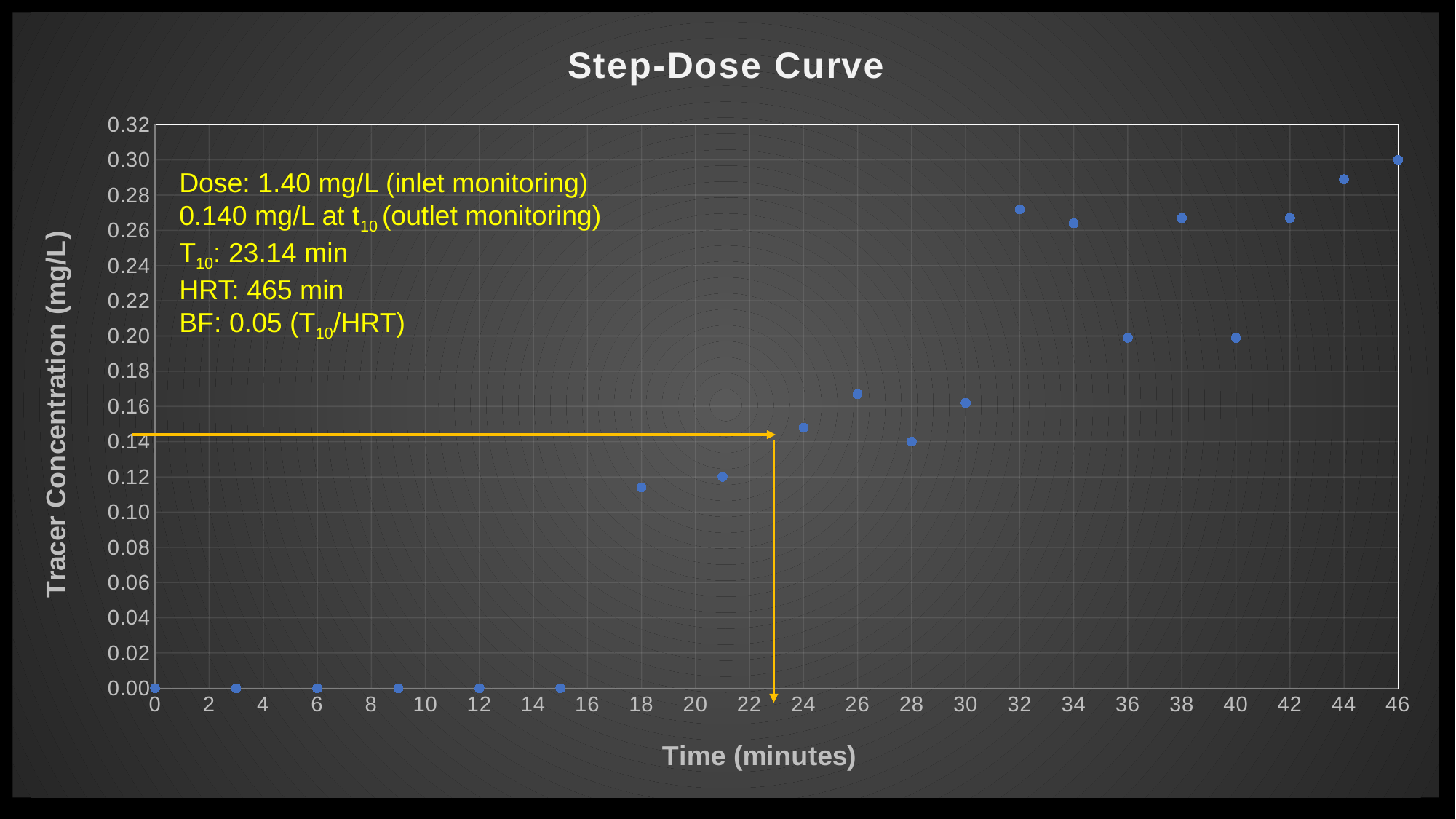
What kind of chart is shown on the slide? Scatter chart Which has the higher tracer concentration, 26 minutes or 28 minutes? 26 minutes What is the title of the chart? Step-Dose Curve Is the tracer concentration at 18 minutes greater or less than 0.10? greater How many data points are plotted on the chart? 20 What is the tracer concentration at 0 minutes? 0.00 What is the label of the x axis? Time (minutes) Is the tracer concentration at 32 minutes greater or less than 0.26? greater What is the tracer concentration at 12 minutes? 0.00 At which time is the tracer concentration highest? 46 minutes Overall, does the tracer concentration rise or fall as time increases? Rise Is the tracer concentration at 36 minutes greater or less than 0.24? less